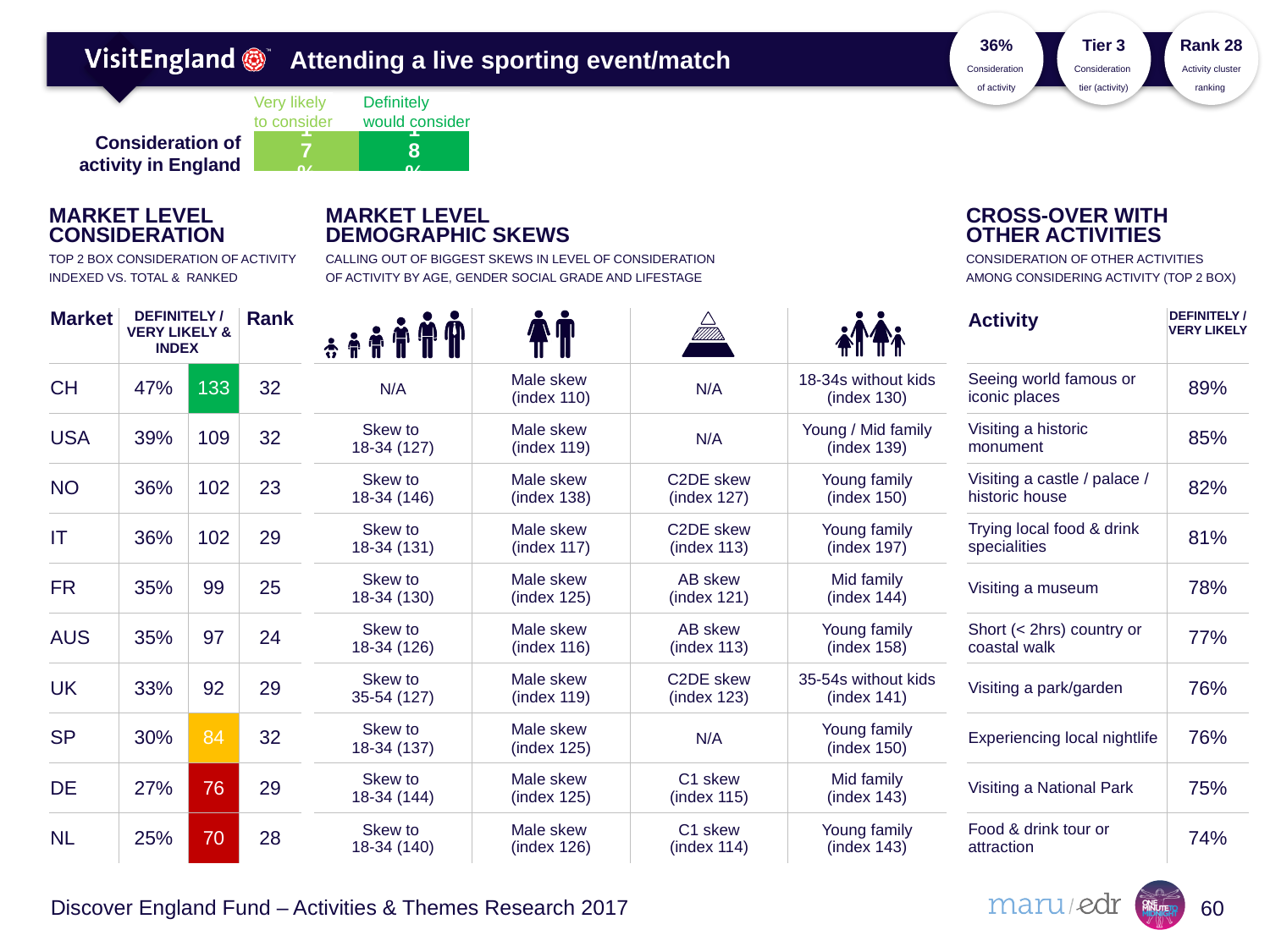
What is the value for 'Very likely to consider' in the 'Consideration of activity in England' chart? 17% In the 'Consideration of activity in England' chart, what is the difference between 'Definitely would consider' and 'Very likely to consider'? 1% What kind of chart is the 'Consideration of activity in England' chart? bar chart How many categories are shown in the 'Consideration of activity in England' chart? 2 What are the two categories shown in the 'Consideration of activity in England' chart? Very likely to consider; Definitely would consider What is the value for 'Definitely would consider' in the 'Consideration of activity in England' chart? 18% What colour are the bars in the 'Consideration of activity in England' chart? green